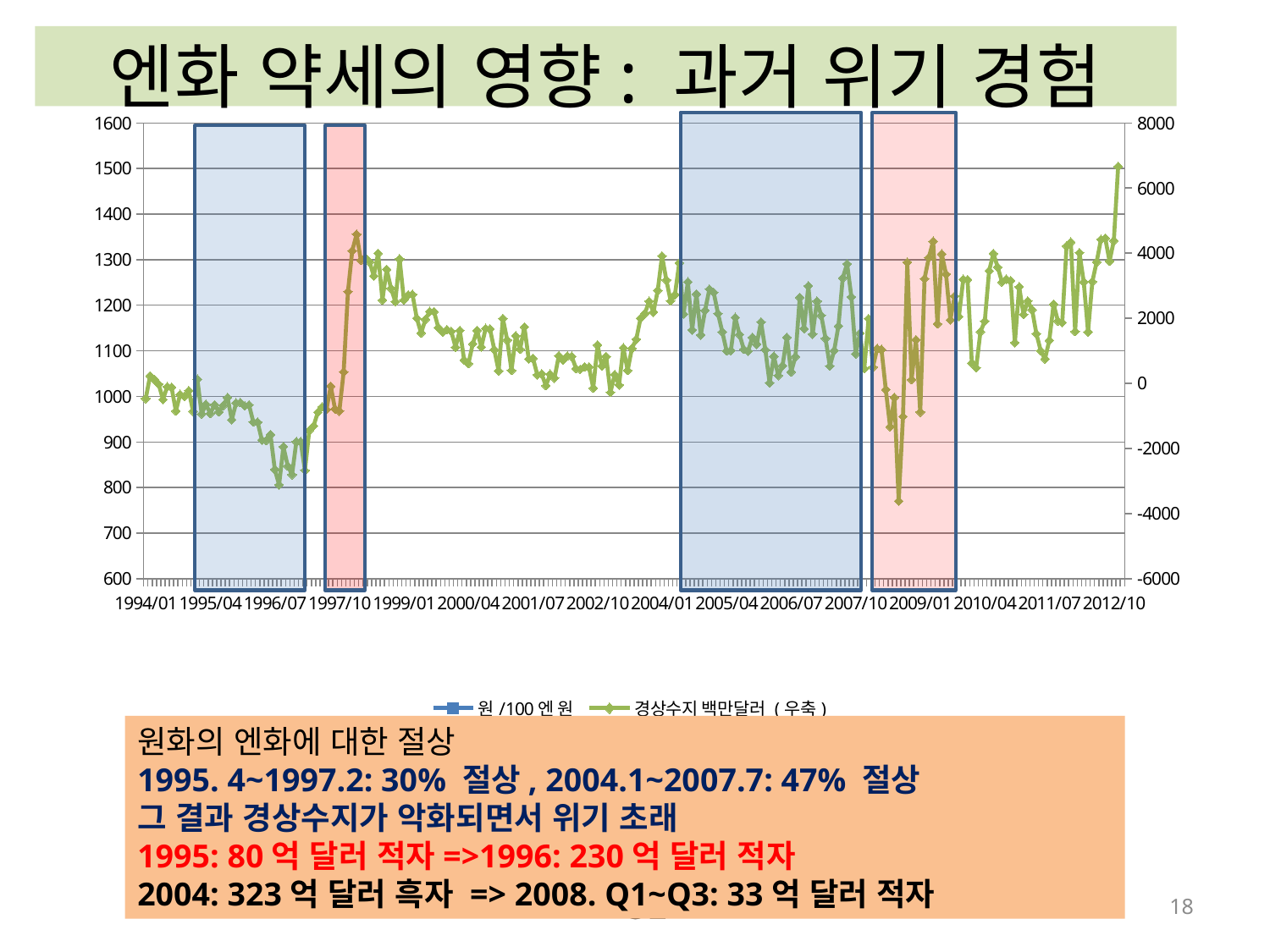
How many series does the chart legend list? 2 Is the 경상수지 value at the peak around 1998 greater or less than 6000 on the right axis? less Is the lowest 경상수지 value in the 2008 shaded period greater or less than -2000 on the right axis? less Is the 경상수지 value at the last point (2012/10) greater or less than 6000 on the right axis? greater Is the 경상수지 peak at 2012/10 higher or lower than the peak around 1998? higher Which series does the legend say is plotted on the right axis (우축)? 경상수지 백만달러 What is the highest tick value shown on the right-hand axis of the chart? 8000 What kind of chart is shown on the slide? line chart